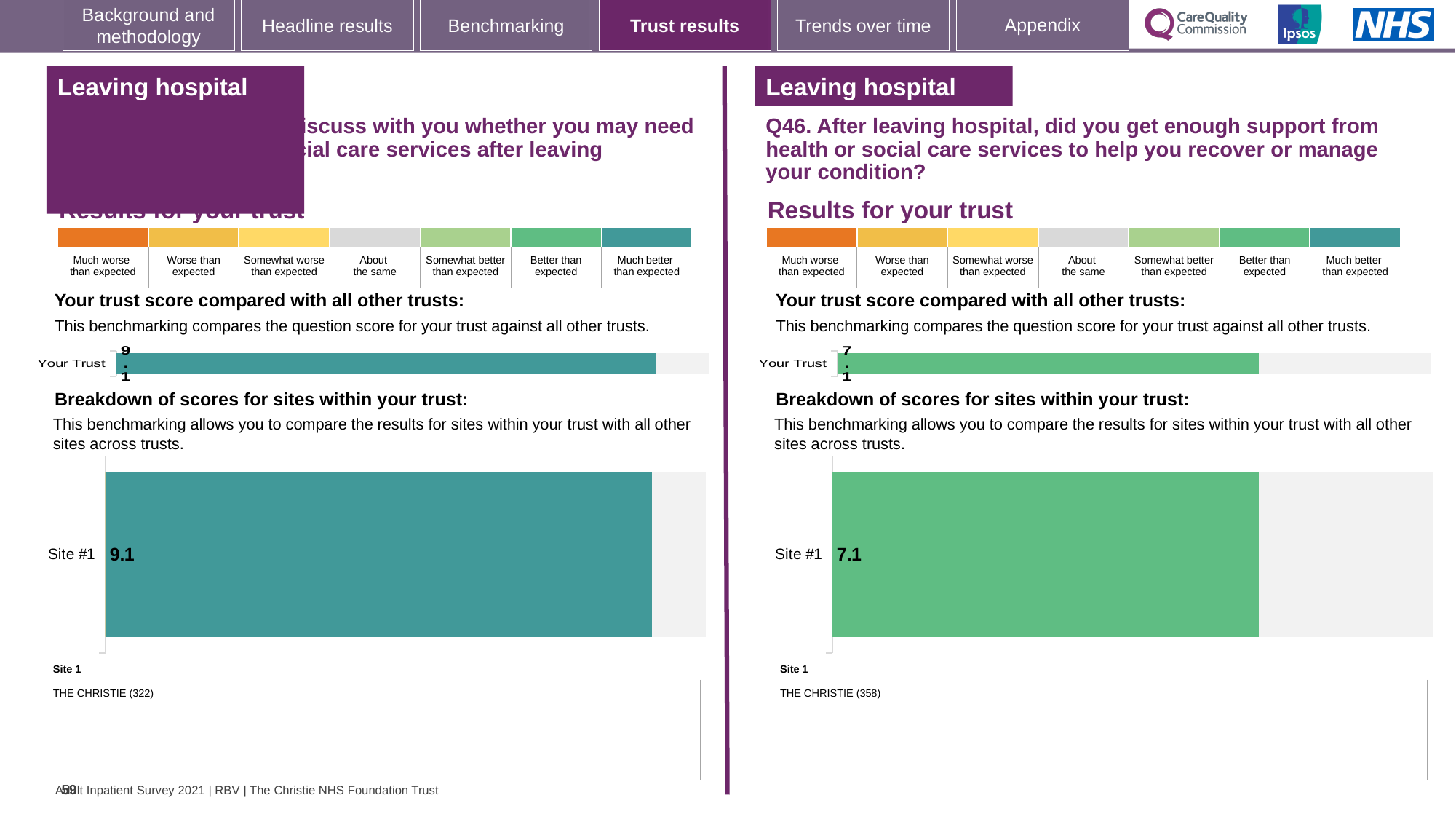
How many benchmark categories are shown in the colour key above each 'Results for your trust' section? 7 Which benchmark category colour does the Your Trust bar on the right-hand side of the slide (Q46) match? Better than expected What is the difference between the Site #1 score on the left-hand side of the slide and the Site #1 score on the right-hand side (Q46)? 2.0 How many sites are shown in the right-hand 'Breakdown of scores for sites within your trust' chart (Q46)? 1 In the left-hand 'Breakdown of scores for sites within your trust' chart, what is the score for Site #1? 9.1 What is the name of Site 1 listed under the right-hand chart (Q46)? THE CHRISTIE (358) On the right-hand side of the slide (Q46), what is the score shown for Your Trust? 7.1 Which benchmark category colour does the Your Trust bar on the left-hand side of the slide match? Much better than expected In the right-hand 'Breakdown of scores for sites within your trust' chart (Q46), what is the score for Site #1? 7.1 What type of chart is used to show the Site #1 score on the left-hand side of the slide? Bar chart On the left-hand side of the slide, what is the score shown for Your Trust? 9.1 Which is larger: the Your Trust score on the left-hand side of the slide or the Your Trust score on the right-hand side (Q46)? Left-hand side (9.1)